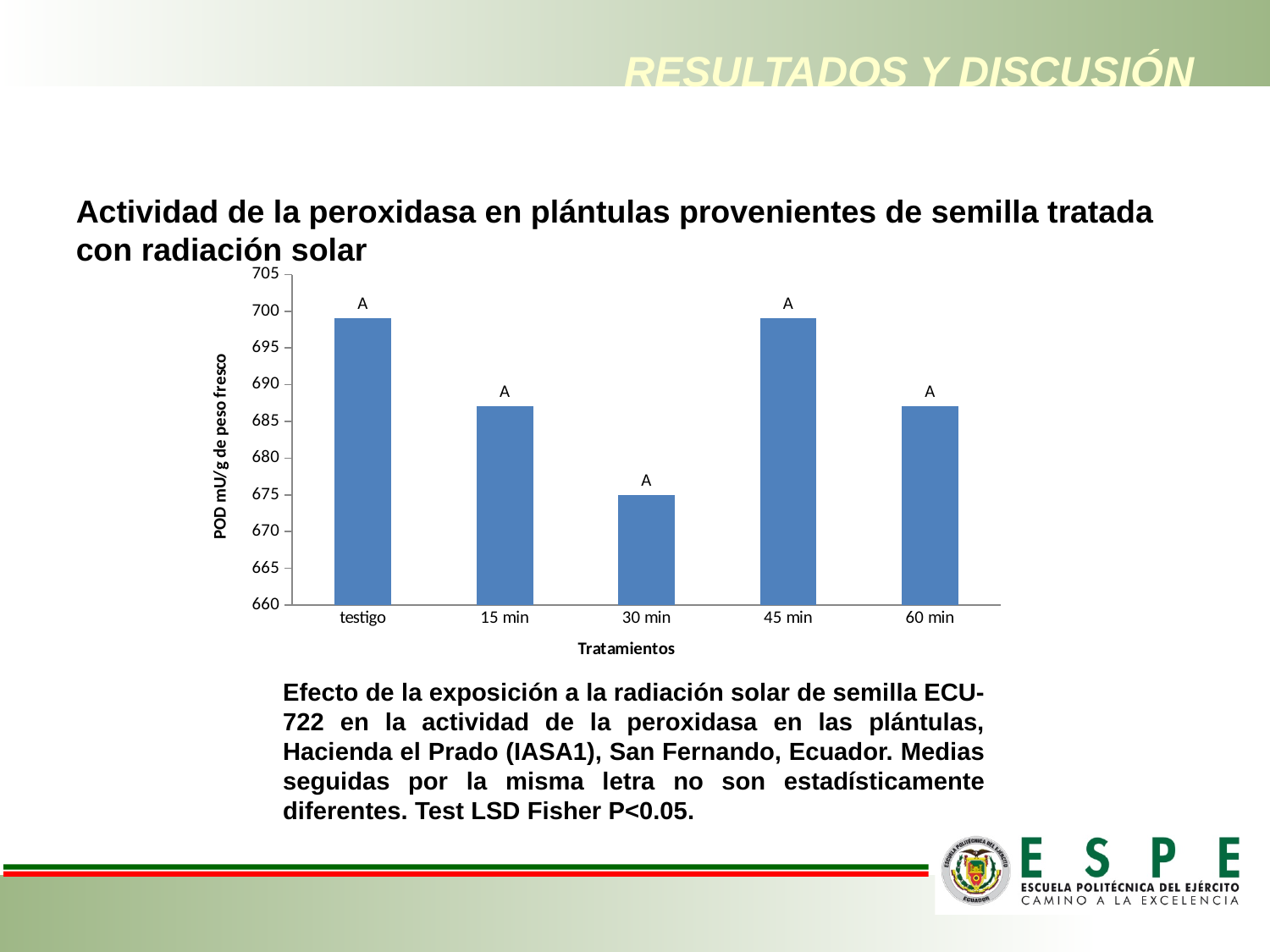
Which is larger, the value for testigo or the value for 15 min? testigo Is the value for testigo greater or less than 695? greater What is the title of the x axis? Tratamientos Is the value for 30 min greater or less than 680? less Is the value for 60 min greater or less than 690? less How many treatment categories are plotted on the x axis? 5 What is the peroxidase activity value for the 30 min treatment? 675 Which is larger, the value for 45 min or the value for 30 min? 45 min What is the title of the y axis? POD mU/g de peso fresco What kind of chart is shown on the slide? bar chart Which treatment has the lowest peroxidase activity? 30 min